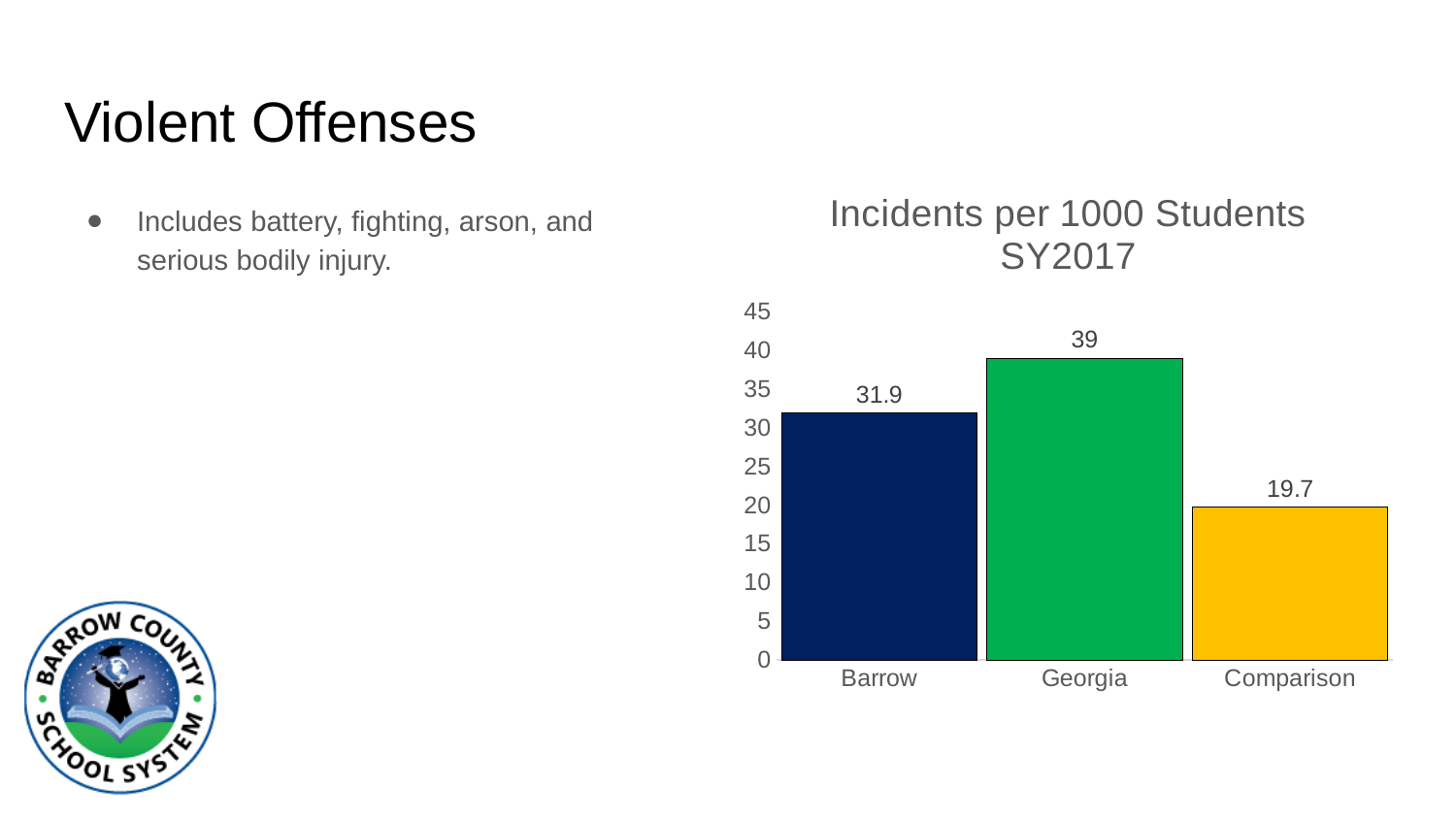
What is the difference between the values for Barrow and Comparison? 12.2 What is the value for Comparison in the chart? 19.7 Which is larger, the value for Barrow or the value for Comparison? Barrow Which category has the lowest value? Comparison Which category has the highest value? Georgia What is the title of the chart? Incidents per 1000 Students SY2017 What is the value for Barrow in the chart? 31.9 How many categories are shown in the chart? 3 What kind of chart is shown on the slide? bar chart What is the difference between the values for Georgia and Barrow? 7.1 What is the value for Georgia in the chart? 39 Is the value for Comparison greater or less than 25? less